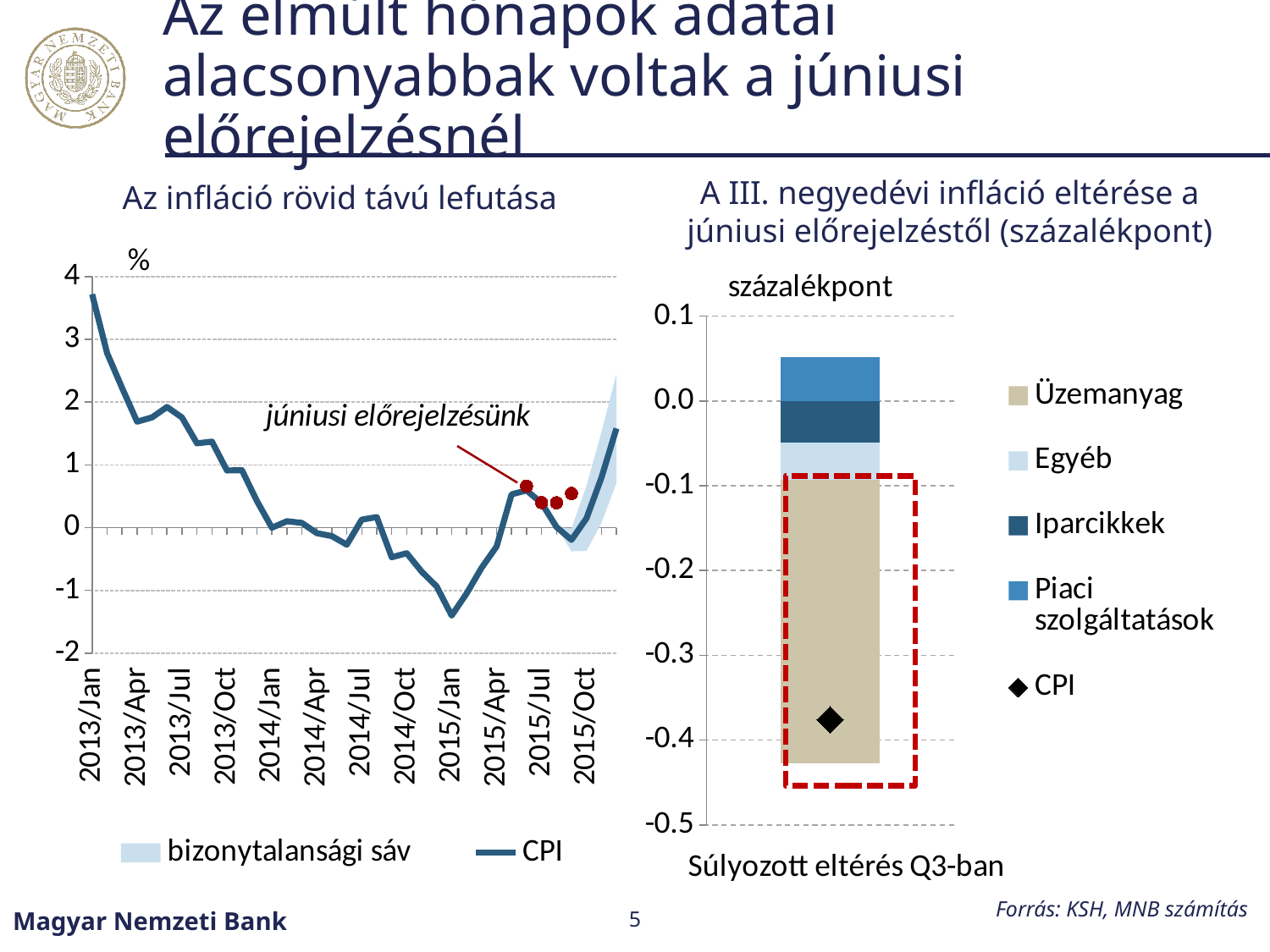
What kind of chart is the right chart, 'A III. negyedévi infláció eltérése a júniusi előrejelzéstől'? stacked bar chart What unit is shown on the y axis of the left chart? % In the left chart, is the CPI value at 2013/Jan greater or less than 3? greater How many entries does the legend of the left chart list? 2 In the right chart, which component has the largest negative contribution? Üzemanyag In the right chart, is the CPI marker greater or less than -0.3? less What kind of chart is the left chart, 'Az infláció rövid távú lefutása'? line chart In the left chart, is the CPI value at 2015/Jan greater or less than -1? less In the right chart, which component has a positive contribution? Piaci szolgáltatások How many entries does the legend of the right chart list? 5 In the left chart, does the CPI line rise or fall between 2013/Jan and 2014/Jan? fall